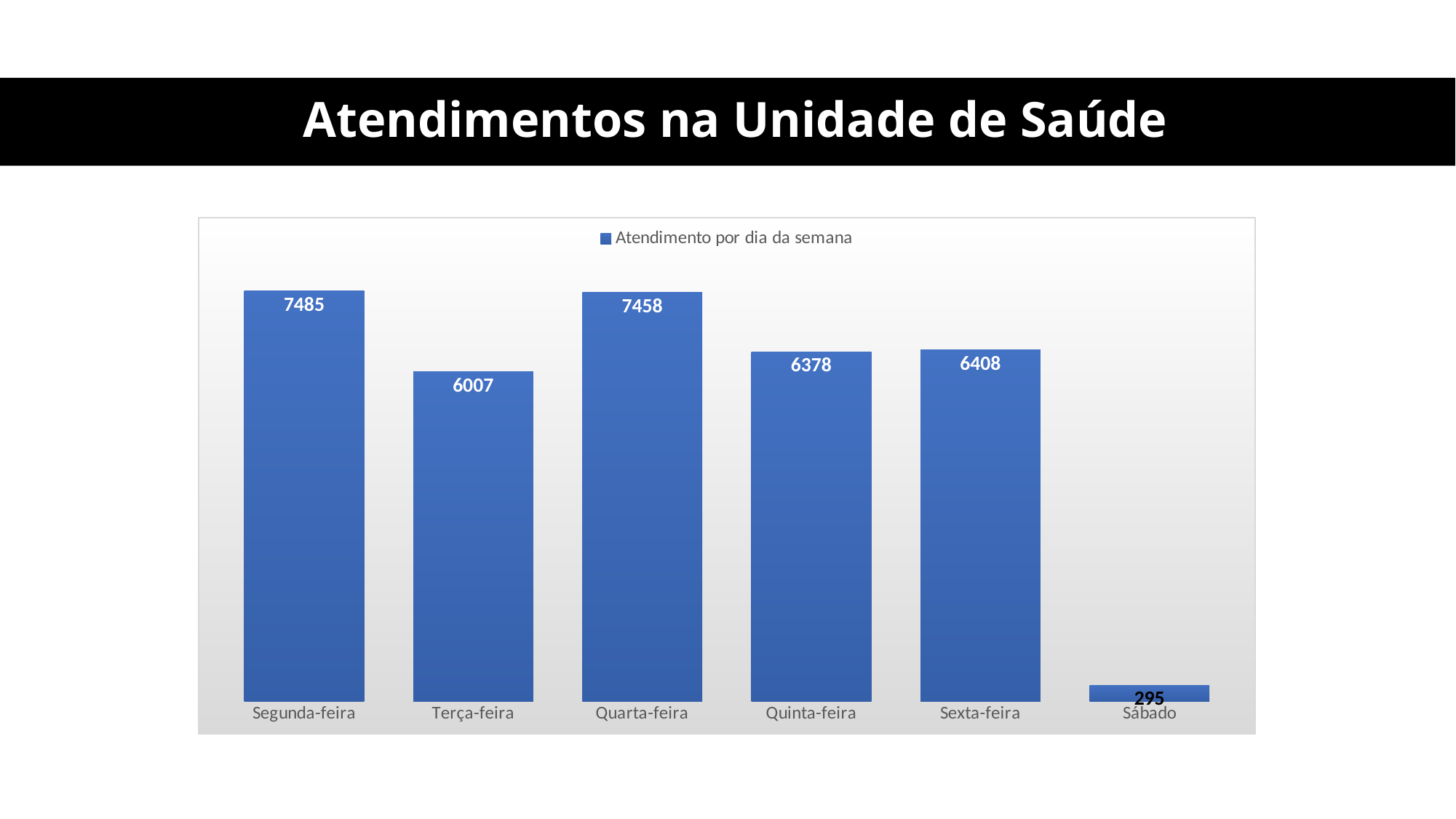
What is the value for Sábado? 295 How many series does the legend list? 1 Which day has the highest value? Segunda-feira What kind of chart is shown on the slide? Bar chart What is the legend entry of the chart? Atendimento por dia da semana How many days are shown on the x axis? 6 What is the difference between the values for Sexta-feira and Quinta-feira? 30 Which is larger, the value for Quarta-feira or the value for Quinta-feira? Quarta-feira What is the difference between the values for Segunda-feira and Terça-feira? 1478 What is the value for Segunda-feira? 7485 Which day has the lowest value? Sábado What is the value for Terça-feira? 6007